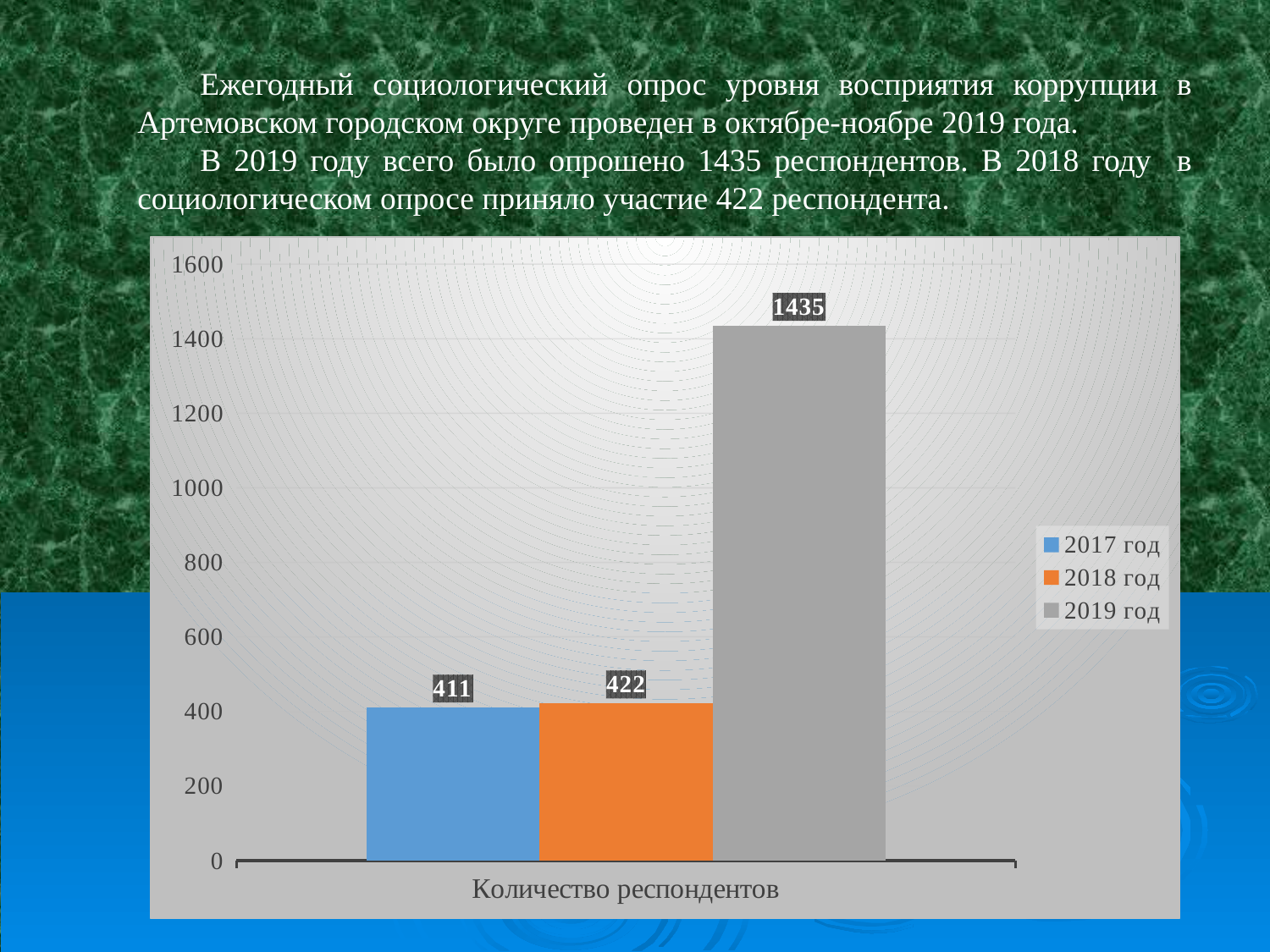
What is the value for 2019 год in the chart? 1435 How many series does the legend list? 3 What kind of chart is shown on the slide? bar chart Which series has the lowest value in the chart? 2017 год What is the value for 2017 год in the chart? 411 What is the difference between the values for 2019 год and 2018 год? 1013 What is the difference between the values for 2018 год and 2017 год? 11 Which series has the highest value in the chart? 2019 год What is the label on the x axis of the chart? Количество респондентов What is the value for 2018 год in the chart? 422 Which is larger, the value for 2019 год or the value for 2017 год? 2019 год Is the value for 2019 год greater or less than 1400? greater